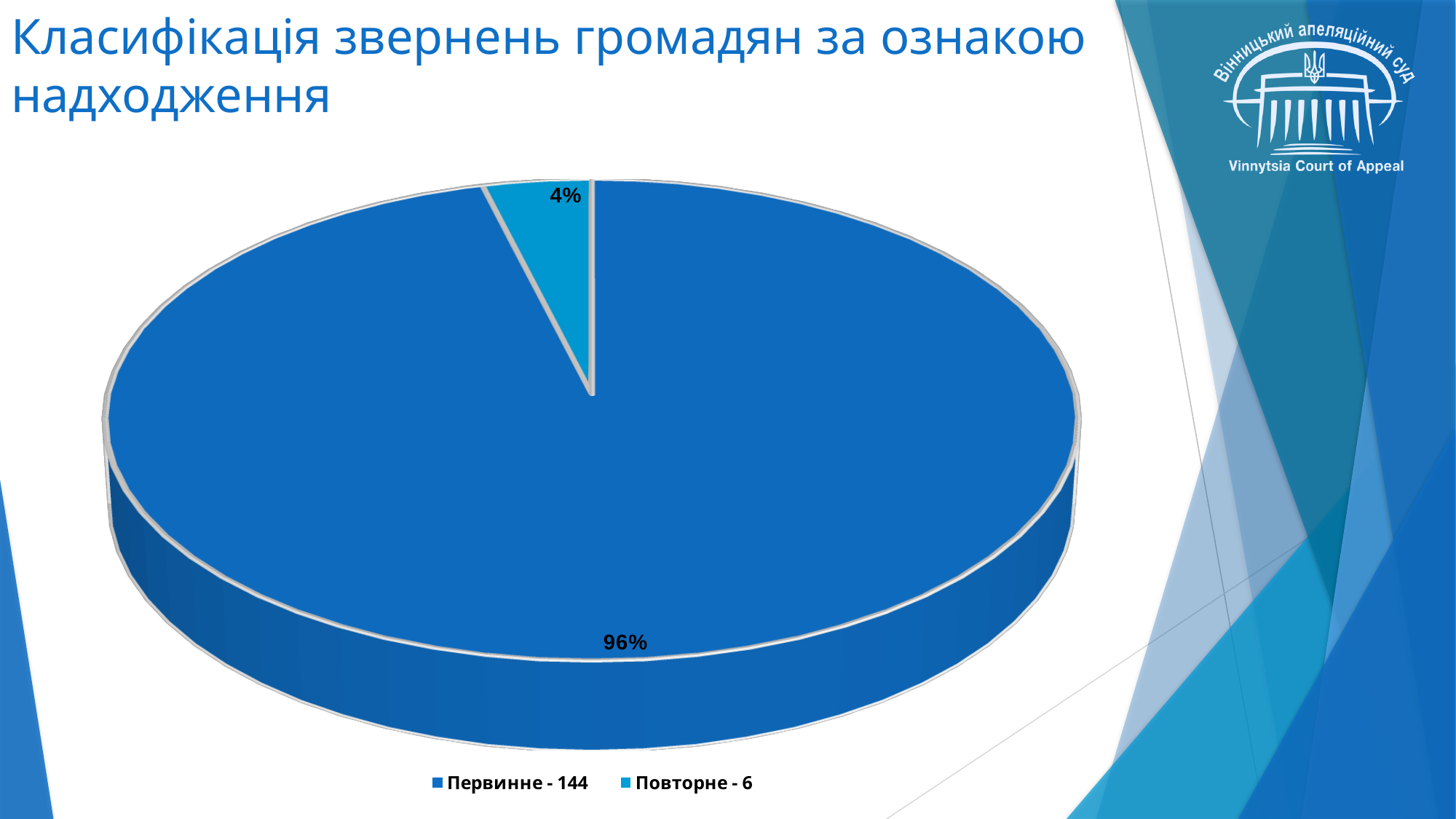
How many slices does the pie chart have? 2 What is the title of the slide containing the chart? Класифікація звернень громадян за ознакою надходження What is the count shown in the legend for the "Повторне" category? 6 What percentage share does the "Повторне - 6" slice have? 4% What percentage share does the "Первинне - 144" slice have? 96% Which slice is larger, "Первинне - 144" or "Повторне - 6"? Первинне - 144 How many entries does the legend list? 2 What kind of chart is shown on the slide? Pie chart What is the difference in percentage points between the "Первинне" slice and the "Повторне" slice? 92 What is the count shown in the legend for the "Первинне" category? 144 Which category has the largest slice of the pie? Первинне - 144 Which category has the smallest slice of the pie? Повторне - 6